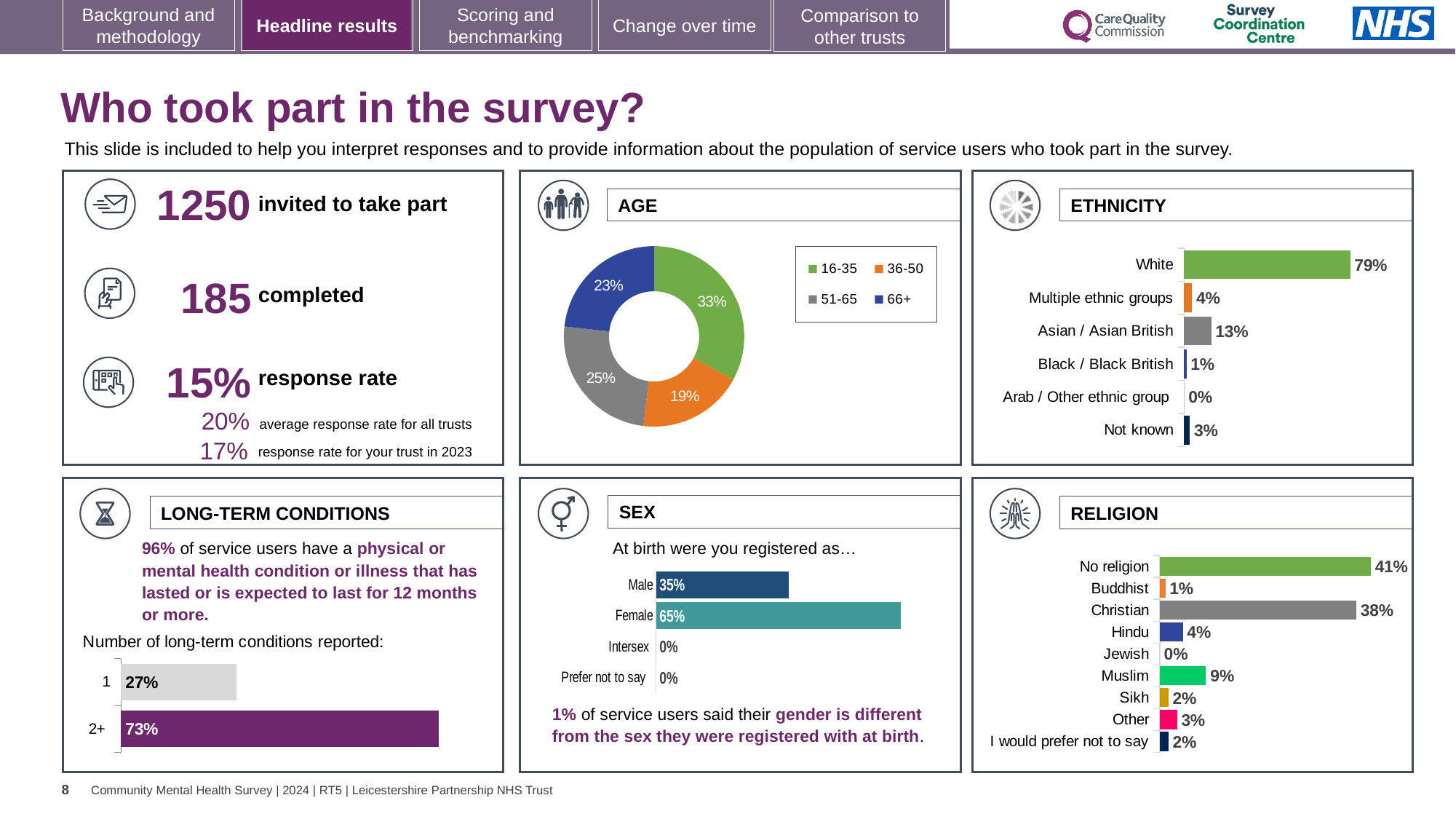
In the RELIGION chart, what is the value for Muslim? 9% In the AGE chart, what percentage of respondents were aged 16-35? 33% How many categories does the legend of the AGE chart list? 4 In the ETHNICITY chart, what is the difference between White and Asian / Asian British? 66% How many categories are shown in the ETHNICITY chart? 6 In the RELIGION chart, which is larger, No religion or Christian? No religion In the ETHNICITY chart, which category has the highest value? White In the AGE chart, which age group has the smallest share? 36-50 In the LONG-TERM CONDITIONS chart, what percentage reported 2+ conditions? 73% In the ETHNICITY chart, what is the value for Asian / Asian British? 13% In the SEX chart, what is the value for Female? 65% What kind of chart is the AGE chart? Doughnut chart